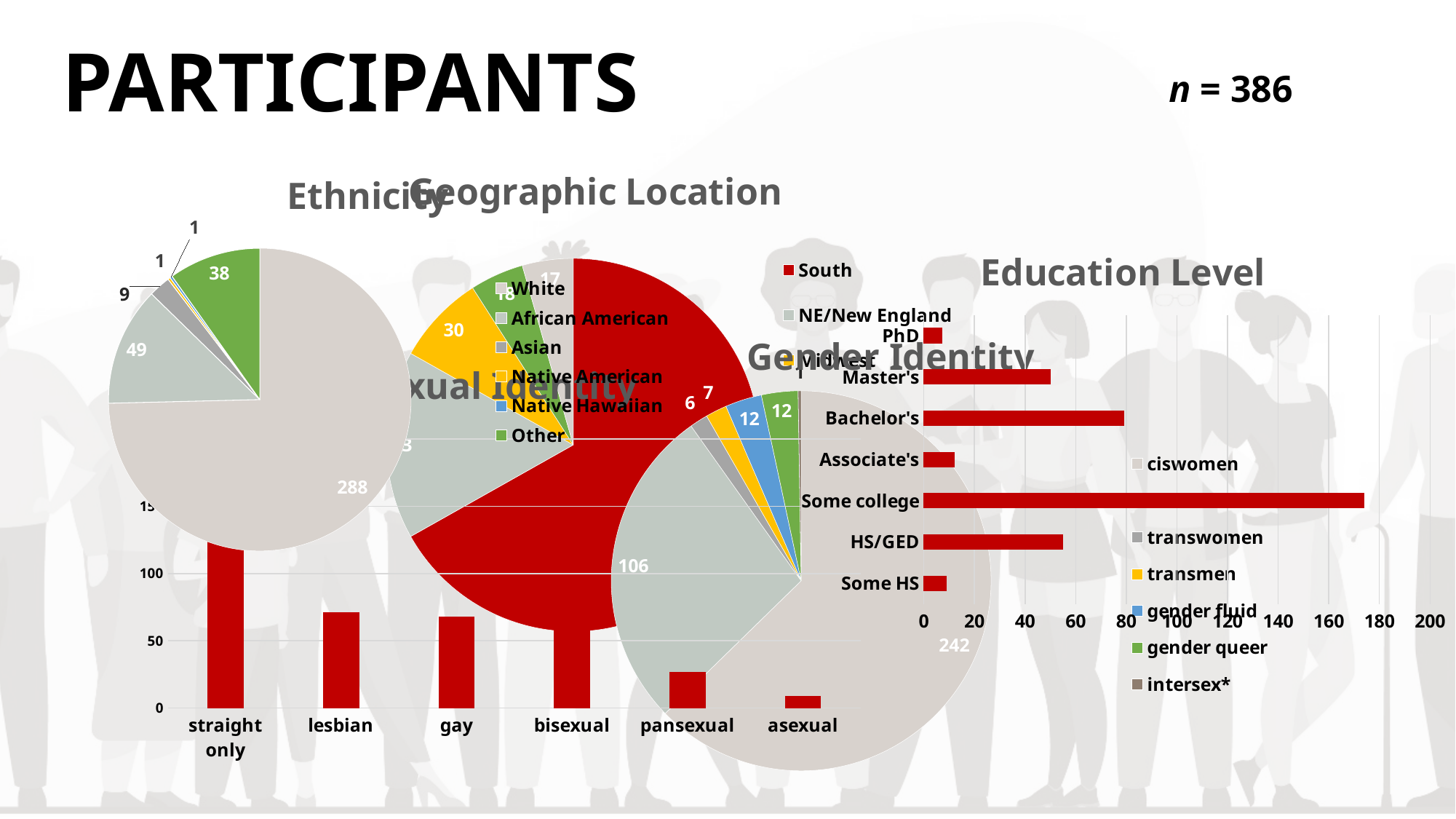
In the Education Level bar chart, which category has the highest value? Some college In the Sexual Identity bar chart, which category has the lowest value? asexual In the Gender Identity pie chart, how many participants are ciswomen? 242 In the Education Level bar chart, is the value for Some college greater or less than 160? greater In the Ethnicity pie chart, which is larger, Other or Asian? Other In the Ethnicity pie chart, how many participants are African American? 49 In the Ethnicity pie chart, which category is the largest? White In the Ethnicity pie chart, how many participants are White? 288 In the Ethnicity pie chart, what is the difference between the African American and Asian values? 40 What kind of chart is the Education Level chart? bar chart In the Education Level bar chart, is the value for Associate's greater or less than 20? less In the Ethnicity pie chart, what is the value for Other? 38